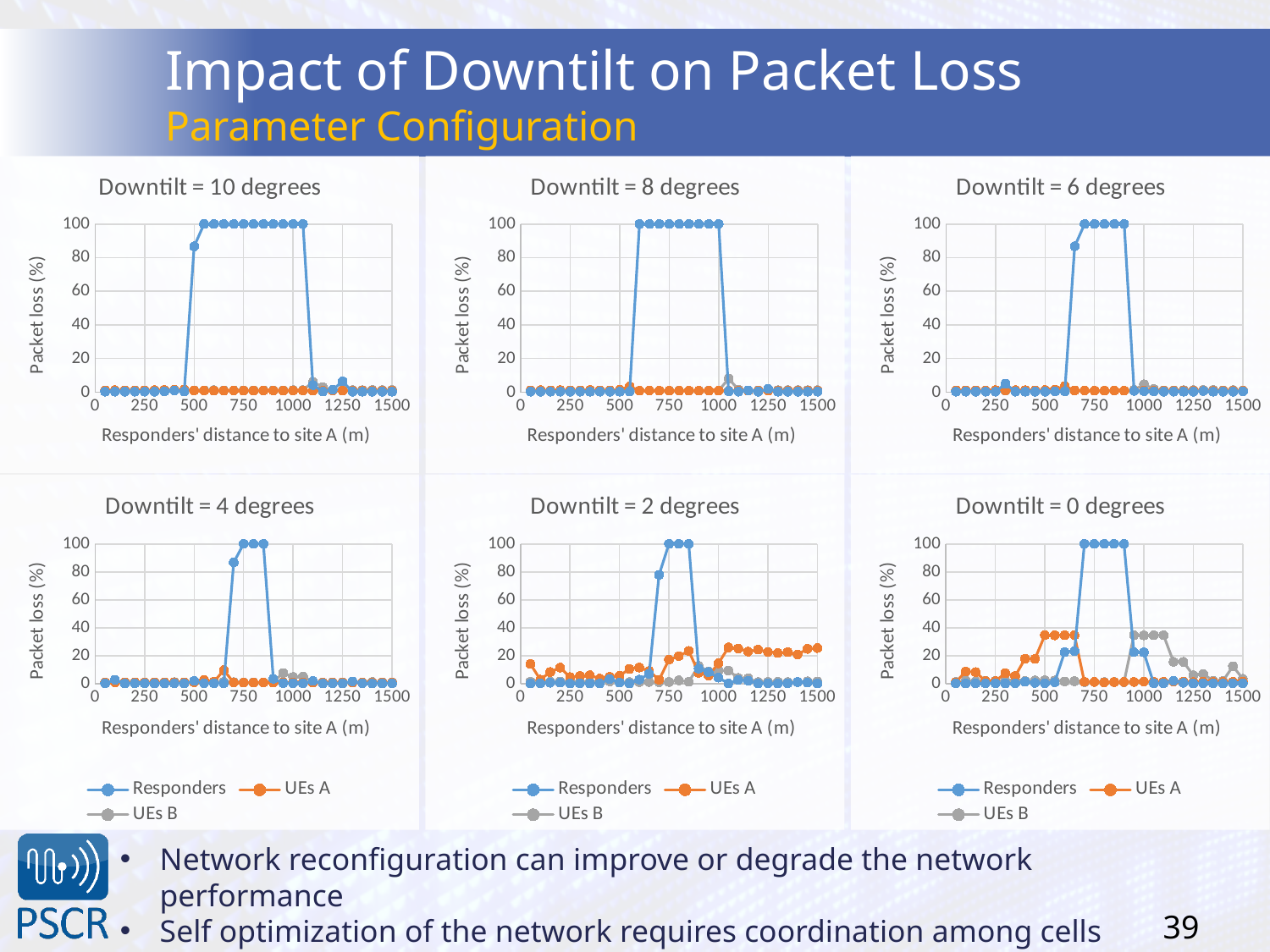
In the 'Downtilt = 0 degrees' chart, is the peak value of the UEs A series greater or less than 20? greater In the 'Downtilt = 2 degrees' chart, is the value of the UEs A series at 1500 m greater or less than 40? less In the 'Downtilt = 0 degrees' chart, is the peak value of the UEs B series greater or less than 60? less What is the y-axis label on the 'Downtilt = 8 degrees' chart? Packet loss (%) How many charts are shown on the slide? 6 In the 'Downtilt = 8 degrees' chart, which series is larger at 750 m: Responders or UEs A? Responders What kind of chart is used in the 'Downtilt = 10 degrees' panel? Line chart How many series does the legend list for the 'Downtilt = 0 degrees' chart? 3 Which series are listed in the legend of the 'Downtilt = 2 degrees' chart? Responders, UEs A, UEs B In the 'Downtilt = 10 degrees' chart, what is the maximum packet loss value reached by the Responders series? 100 In the 'Downtilt = 6 degrees' chart, which series reaches the highest packet loss? Responders